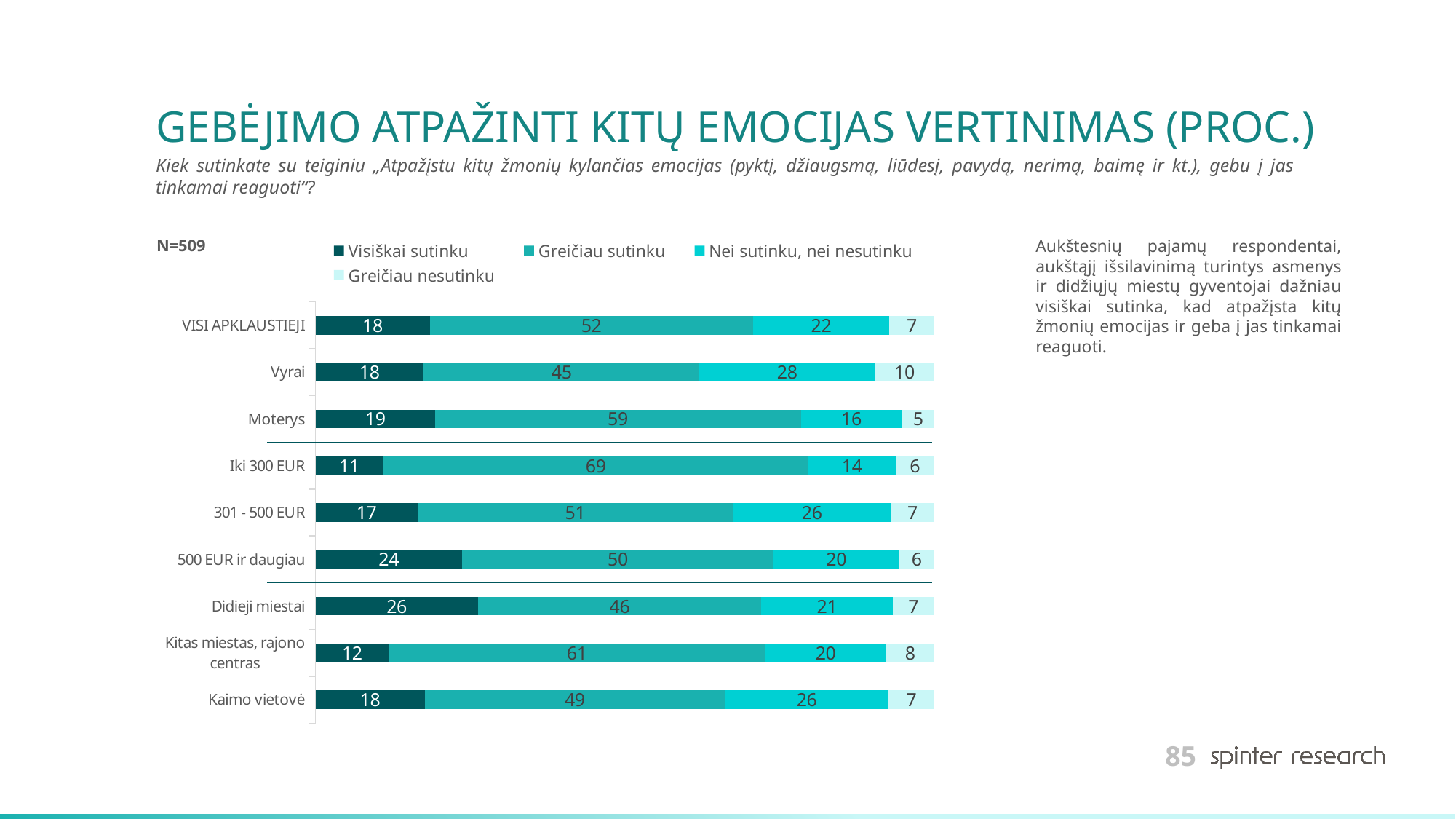
What is the value of "Greičiau sutinku" for "Iki 300 EUR"? 69 What is the value of "Nei sutinku, nei nesutinku" for "Vyrai"? 28 Which category has the highest value for "Visiškai sutinku"? Didieji miestai What is the difference between the "Greičiau sutinku" values for "Moterys" and "Vyrai"? 14 What type of chart is shown on the slide? Stacked bar chart Which is larger: the "Visiškai sutinku" value for "500 EUR ir daugiau" or for "301 - 500 EUR"? 500 EUR ir daugiau Which category has the highest value for "Greičiau nesutinku"? Vyrai How many series does the legend list? 4 Which category has the lowest value for "Visiškai sutinku"? Iki 300 EUR What is the value of "Visiškai sutinku" for "Moterys"? 19 What is the sample size (N) shown on the slide? N=509 How many categories (bars) are shown in the chart? 9